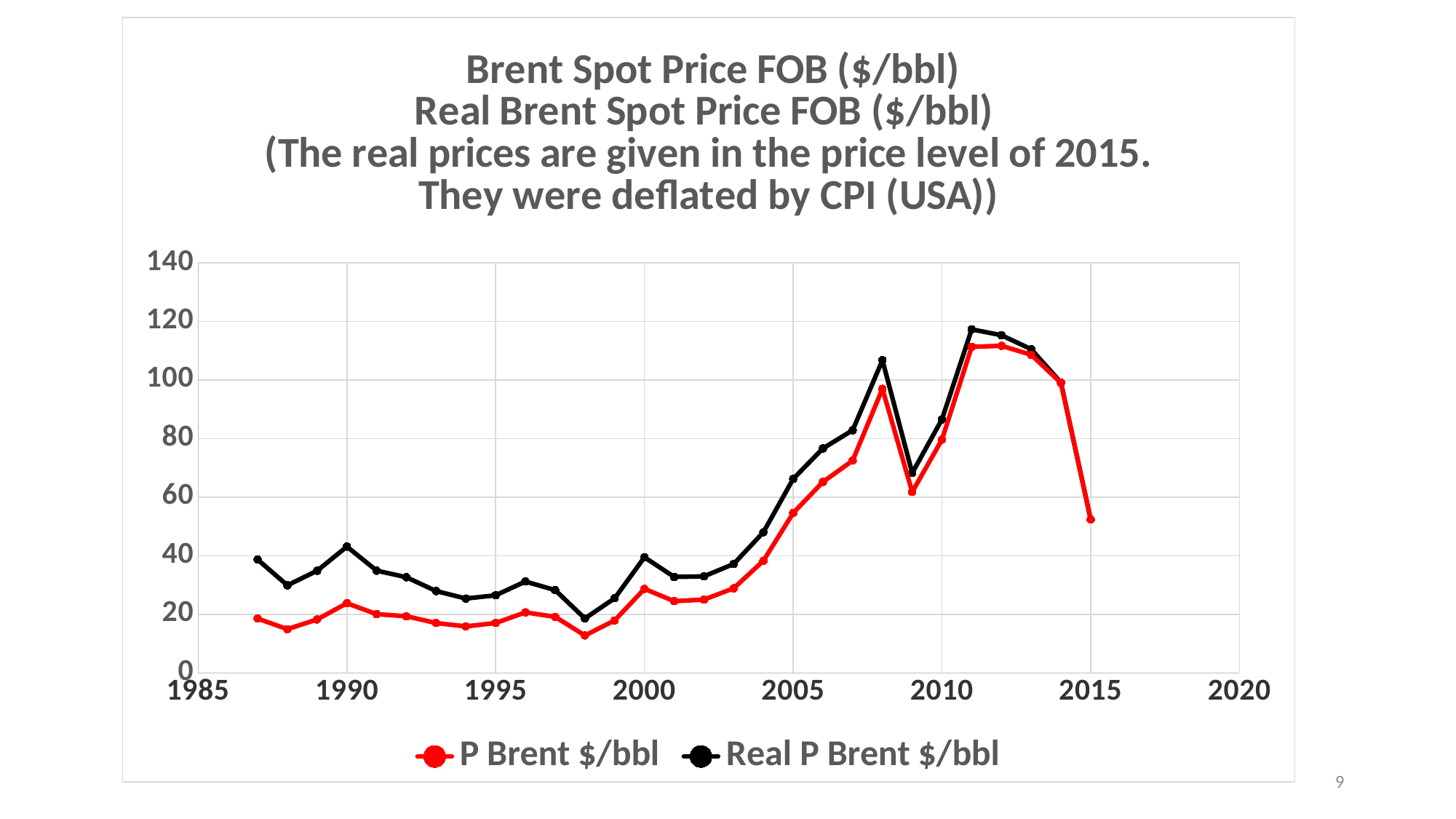
Is the value for Real P Brent $/bbl in 2011 greater or less than 100? greater In which year is the P Brent $/bbl series at its lowest value? 1998 Is the value for P Brent $/bbl in 2015 greater or less than 60? less What kind of chart is shown on the slide? line chart Is the value for P Brent $/bbl in 1998 greater or less than 20? less What colour is the line for the Real P Brent $/bbl series? black How many series does the legend list? 2 Does the P Brent $/bbl series rise or fall between 2012 and 2015? fall In which year is the Real P Brent $/bbl series at its lowest value? 1998 In which year does the Real P Brent $/bbl series reach its highest value? 2011 In 2005, which series has the higher value, P Brent $/bbl or Real P Brent $/bbl? Real P Brent $/bbl